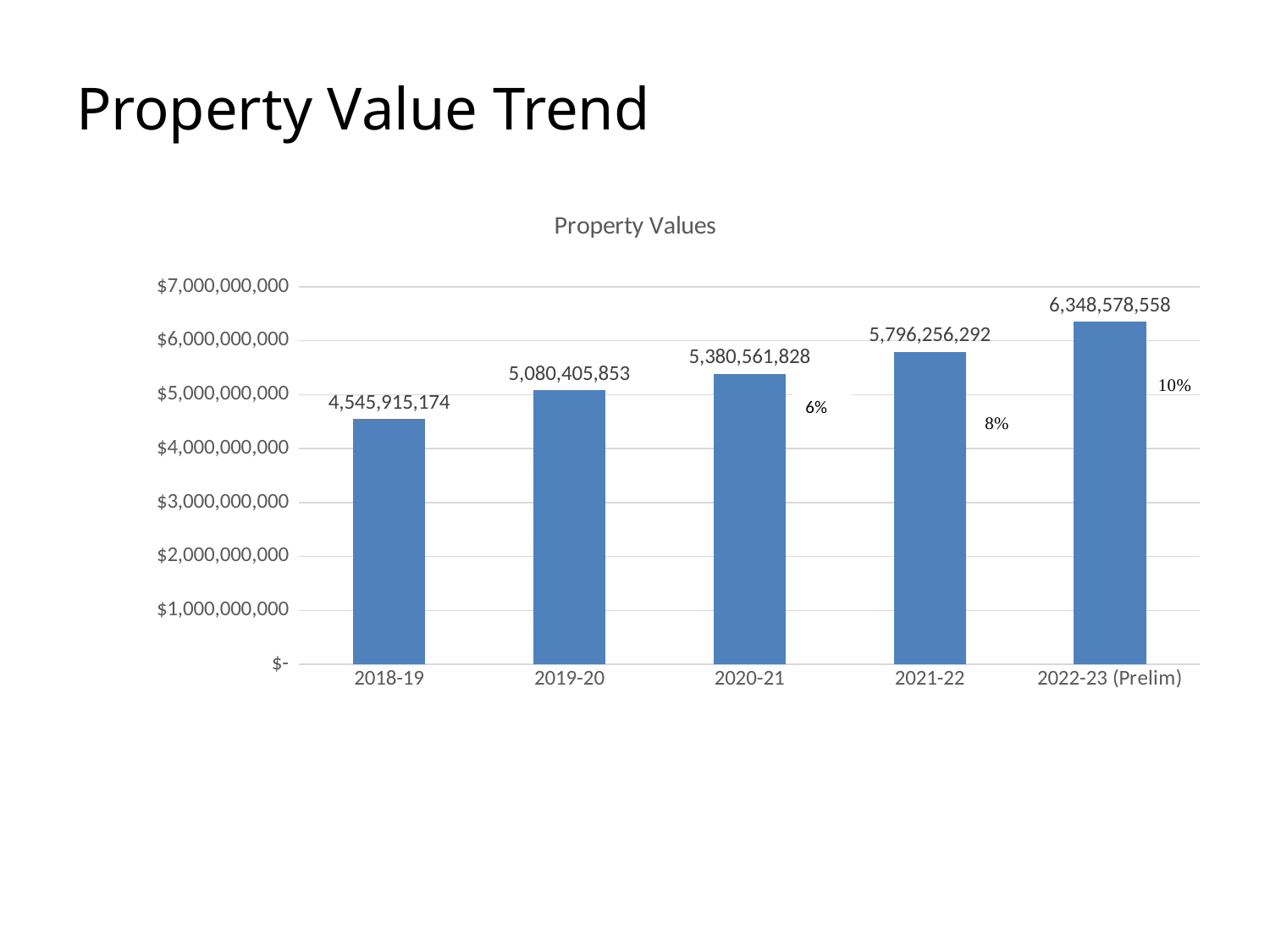
Is the property value for 2018-19 greater or less than $5,000,000,000? less What is the property value for 2022-23 (Prelim)? 6,348,578,558 Which year has the highest property value? 2022-23 (Prelim) What kind of chart is shown on the slide? bar chart What is the property value for 2020-21? 5,380,561,828 What is the property value for 2018-19? 4,545,915,174 What is the difference between the property values for 2022-23 (Prelim) and 2021-22? 552,322,266 Which year has the lowest property value? 2018-19 Do property values rise or fall from 2018-19 to 2022-23 (Prelim)? rise Which is larger, the property value for 2019-20 or for 2021-22? 2021-22 How many years are shown on the chart? 5 What is the difference between the property values for 2019-20 and 2018-19? 534,490,679